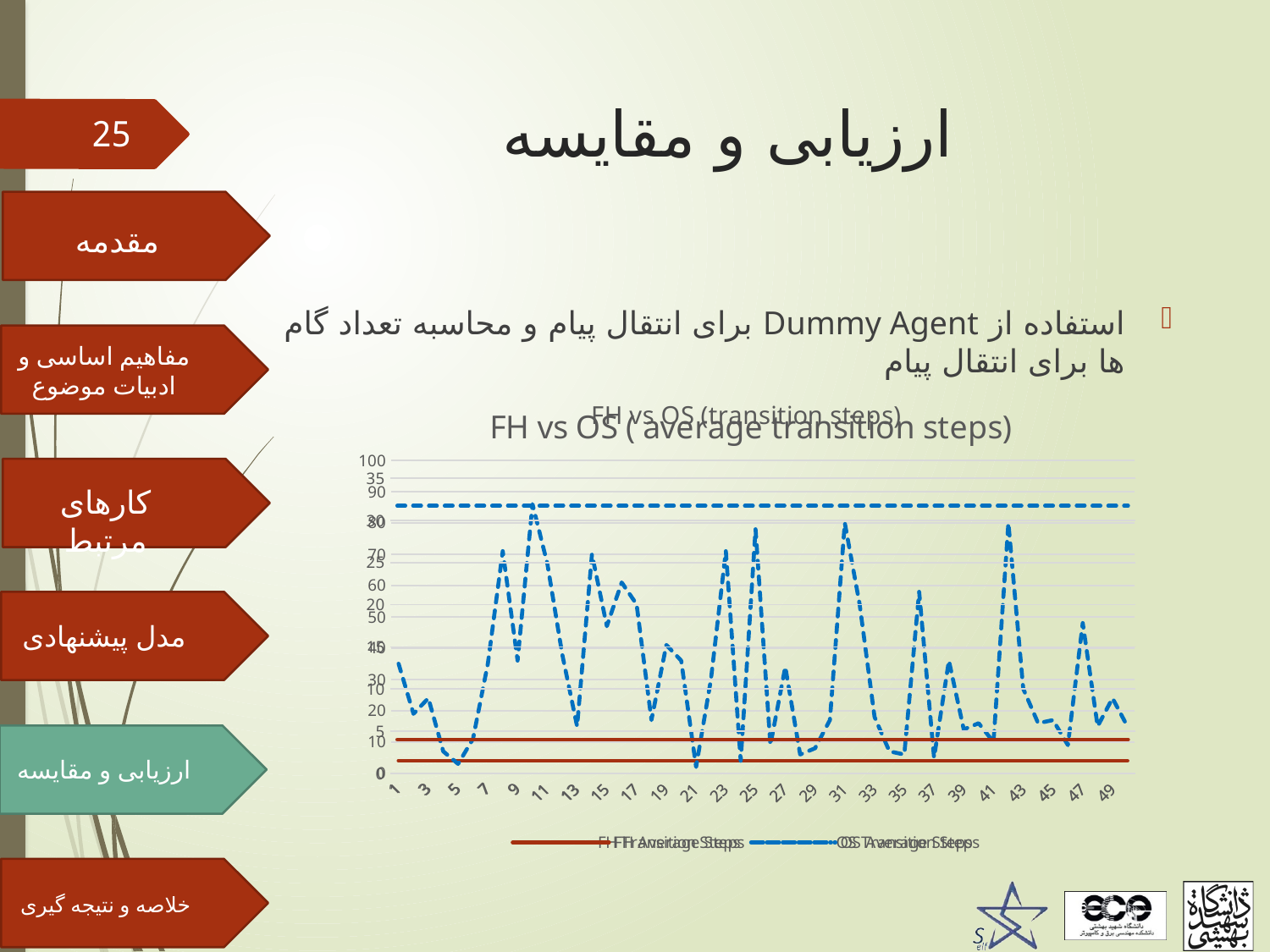
What kind of chart is shown on the slide? line chart How many series does the legend of the FH vs OS (average transition steps) chart list? 2 In the FH vs OS chart, which series is drawn as a blue dashed line? OS What is the last label on the x axis of the FH vs OS chart? 49 In the FH vs OS chart, does the FH line rise, fall, or stay flat along the x axis? stay flat In the FH vs OS chart, which series is drawn as a solid red line? FH